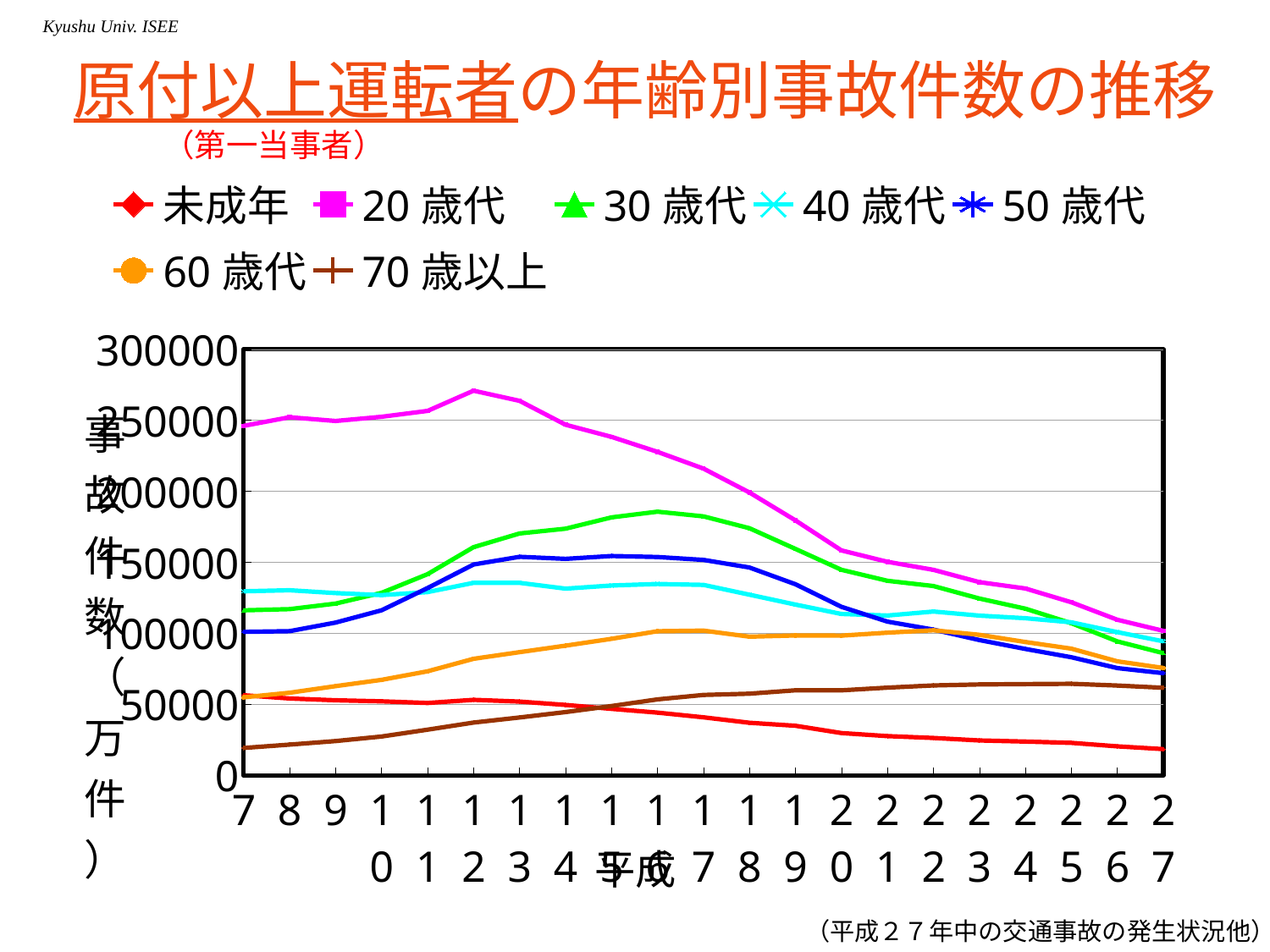
Which age group has the lowest number of accidents in 平成7? 70歳以上 Is the value for 30歳代 in 平成17 greater or less than 150000? greater Does the 未成年 series generally rise or fall from 平成7 to 平成27? fall How many years (points) are shown along the x axis? 21 Is the value for 20歳代 in 平成12 greater or less than 250000? greater How many series does the legend list? 7 Does the 70歳以上 series generally rise or fall from 平成7 to 平成27? rise What kind of chart is shown on the slide? line chart In 平成27, which is larger: the value for 70歳以上 or the value for 未成年? 70歳以上 Which age group has the highest number of accidents in 平成7? 20歳代 Is the value for 未成年 in 平成27 greater or less than 50000? less What is the highest value shown on the y axis? 300000